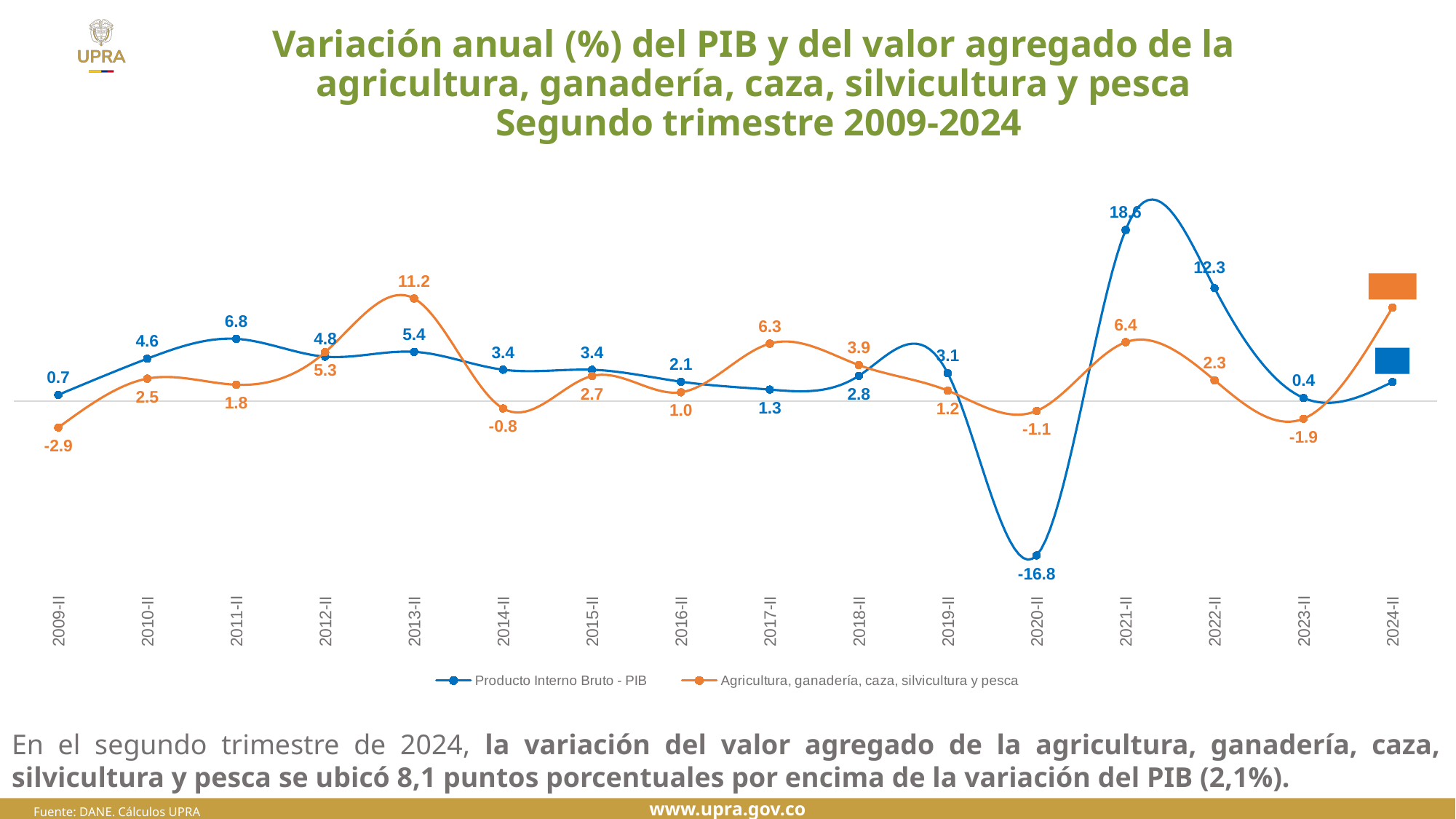
In which period does the Agricultura, ganadería, caza, silvicultura y pesca series reach its highest value? 2013-II In which period does the Producto Interno Bruto - PIB series reach its lowest value? 2020-II What is the value for Agricultura, ganadería, caza, silvicultura y pesca in 2013-II? 11.2 Does the Producto Interno Bruto - PIB series rise or fall from 2021-II to 2023-II? Fall In 2012-II, which series has the larger value: PIB or Agricultura, ganadería, caza, silvicultura y pesca? Agricultura, ganadería, caza, silvicultura y pesca What is the value for Producto Interno Bruto - PIB in 2023-II? 0.4 How many periods are shown on the x axis? 16 How many series does the legend list? 2 What is the value for Producto Interno Bruto - PIB in 2020-II? -16.8 In which period does the Agricultura, ganadería, caza, silvicultura y pesca series reach its lowest value? 2009-II What is the difference between the Agricultura, ganadería, caza, silvicultura y pesca value and the PIB value in 2017-II? 5.0 What type of chart is shown on the slide? Line chart